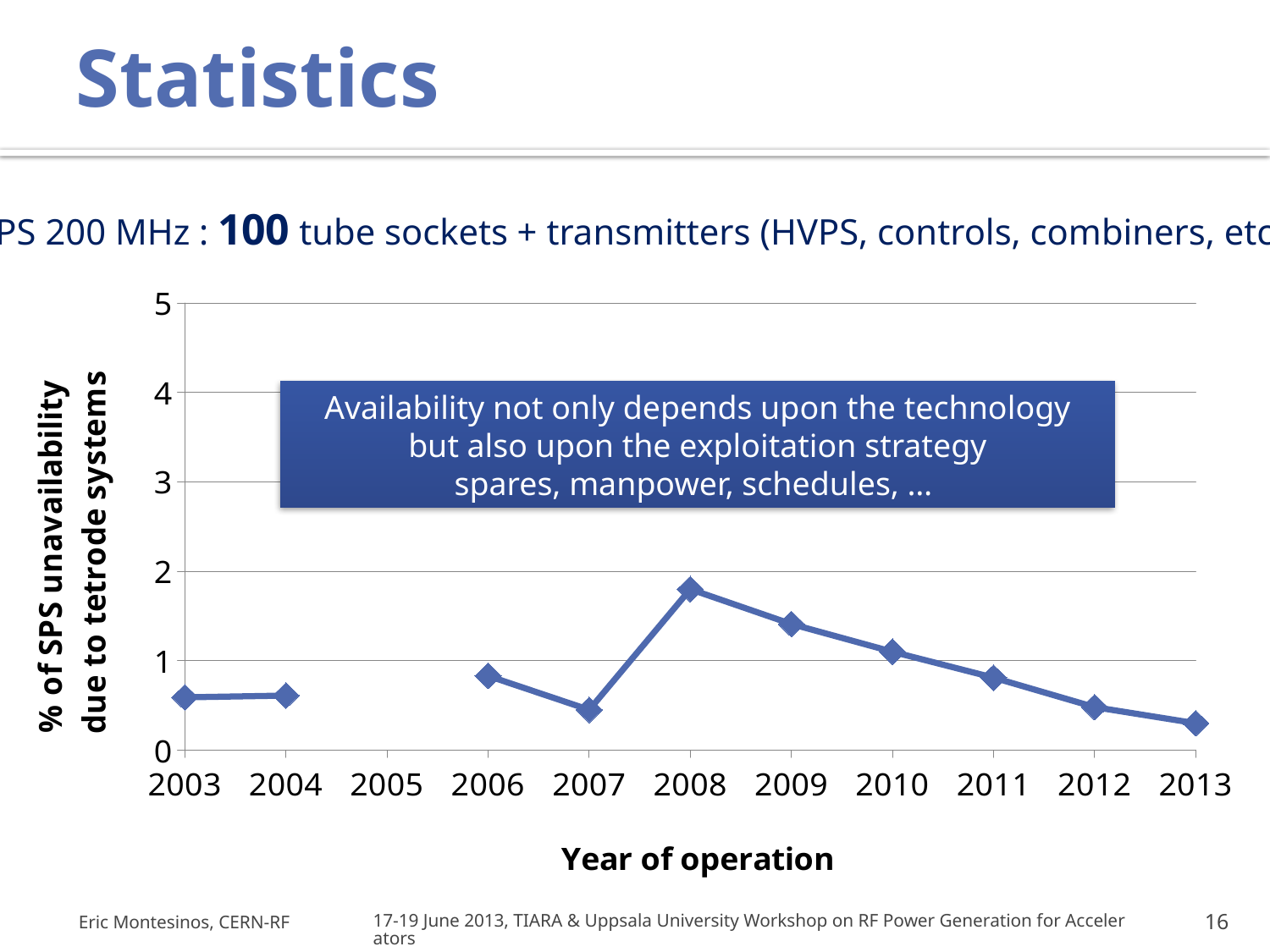
Which year has the highest % of SPS unavailability due to tetrode systems? 2008 Is the value for 2008 greater or less than 1? greater Is the value for 2009 greater or less than 2? less What kind of chart is shown on the slide? line chart Which year has the lowest % of SPS unavailability due to tetrode systems? 2013 What is the title of the x axis? Year of operation Which year has the larger value, 2006 or 2007? 2006 Which year has the larger value, 2008 or 2009? 2008 Is the value for 2013 greater or less than 1? less How many years are labelled on the x axis? 11 Do the values rise or fall from 2008 to 2013? fall